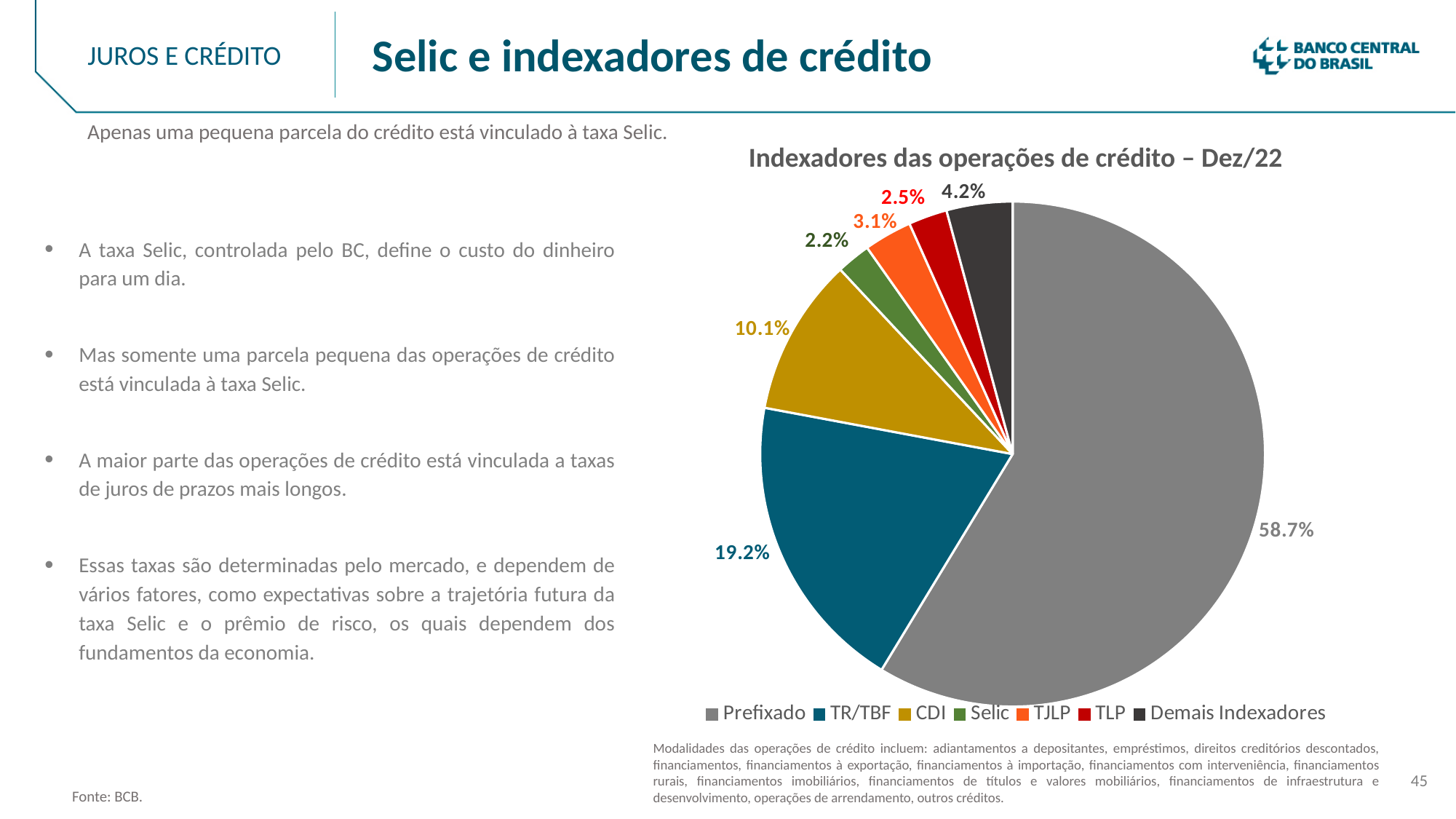
Which indexer has the smallest share of credit operations? Selic What share of credit operations is indexed to TR/TBF? 19.2% What share of credit operations is indexed to Prefixado? 58.7% What type of chart is shown on the slide? Pie chart What is the title of the chart? Indexadores das operações de crédito – Dez/22 What share of credit operations is indexed to Demais Indexadores? 4.2% What share of credit operations is indexed to CDI? 10.1% How many indexers does the legend list? 7 What share of credit operations is indexed to Selic? 2.2% What is the difference in percentage points between the Prefixado and TR/TBF shares? 39.5 Which has a larger share, TJLP or TLP? TJLP Which indexer has the largest share of credit operations? Prefixado